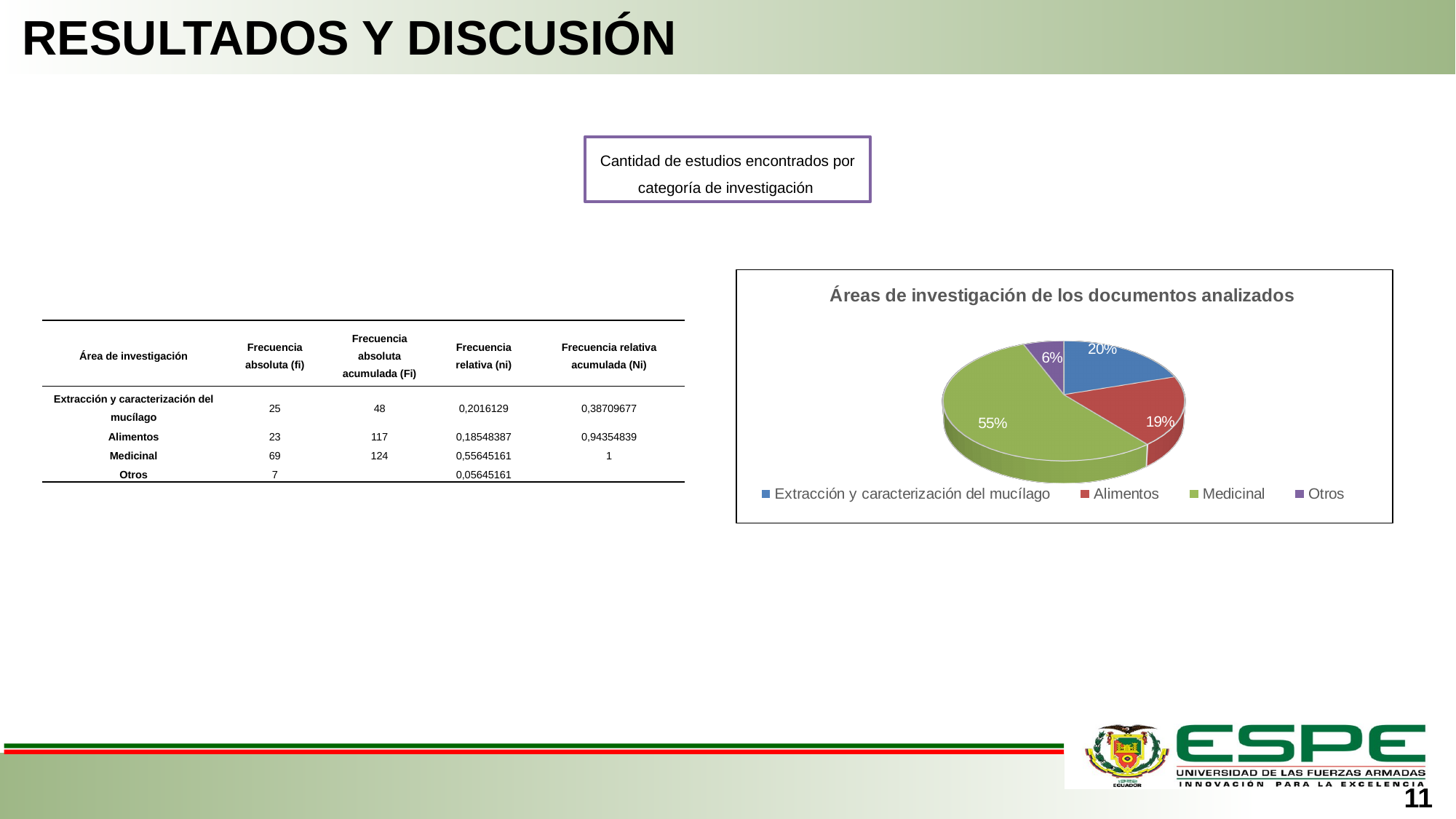
What is the difference in percentage points between the Medicinal slice and the Otros slice? 49 What is the title of the pie chart? Áreas de investigación de los documentos analizados Which category has the smallest slice in the pie chart? Otros What percentage of the pie chart does Medicinal represent? 55% Which colour represents Medicinal in the pie chart? Green Which category has the largest slice in the pie chart? Medicinal How many categories does the pie chart show? 4 What kind of chart is shown on the slide? Pie chart What percentage of the pie chart does Otros represent? 6% What percentage of the pie chart does Extracción y caracterización del mucílago represent? 20% What percentage of the pie chart does Alimentos represent? 19% Which slice is larger in the pie chart, Medicinal or Alimentos? Medicinal